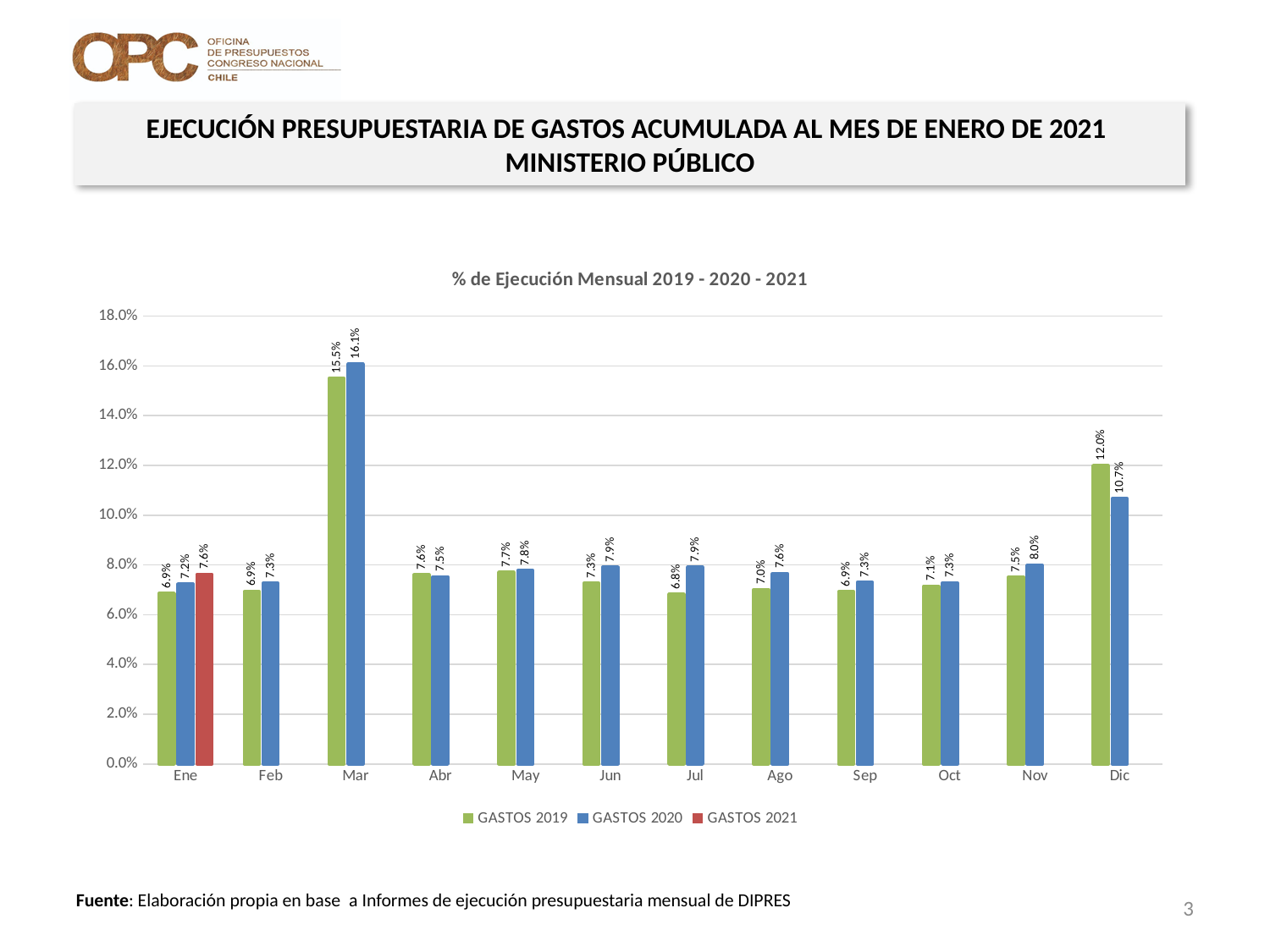
Is the value for GASTOS 2020 in Dic greater or less than 10.0%? greater What is the value for GASTOS 2020 in Mar? 16.1% What is the difference between GASTOS 2020 and GASTOS 2019 in Mar? 0.6% What is the value for GASTOS 2019 in Dic? 12.0% How many months are shown on the x axis? 12 What kind of chart is shown on the slide? Bar chart Which month has the lowest value for GASTOS 2019? Jul What is the value for GASTOS 2021 in Ene? 7.6% Which month has the highest value for GASTOS 2019? Mar In Dic, which series is larger, GASTOS 2019 or GASTOS 2020? GASTOS 2019 How many series does the legend list? 3 What is the title of the chart? % de Ejecución Mensual 2019 - 2020 - 2021